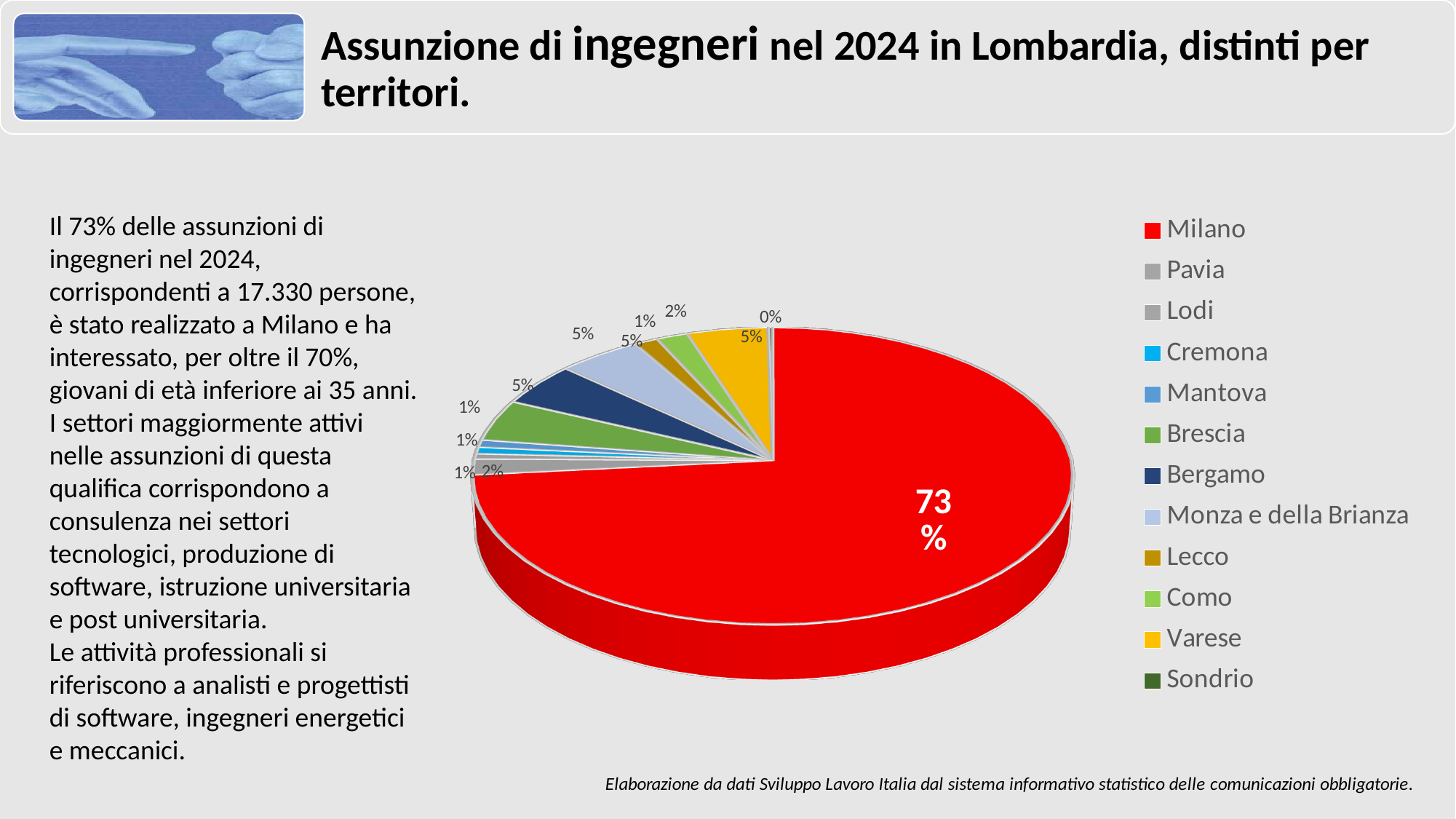
What is the value shown for Brescia? 5% Which territory has the smallest slice of the pie? Sondrio What share of the pie does Milano account for? 73% What is the value shown for Sondrio? 0% Which is larger, the slice for Milano or the slice for Varese? Milano What is the value shown for Varese? 5% How many territories are listed in the legend? 12 What kind of chart is shown on the slide? pie chart What colour is the Milano slice? red Which territory has the largest slice of the pie? Milano What is the value shown for Bergamo? 5% What is the difference between the Milano share and the Varese share? 68%